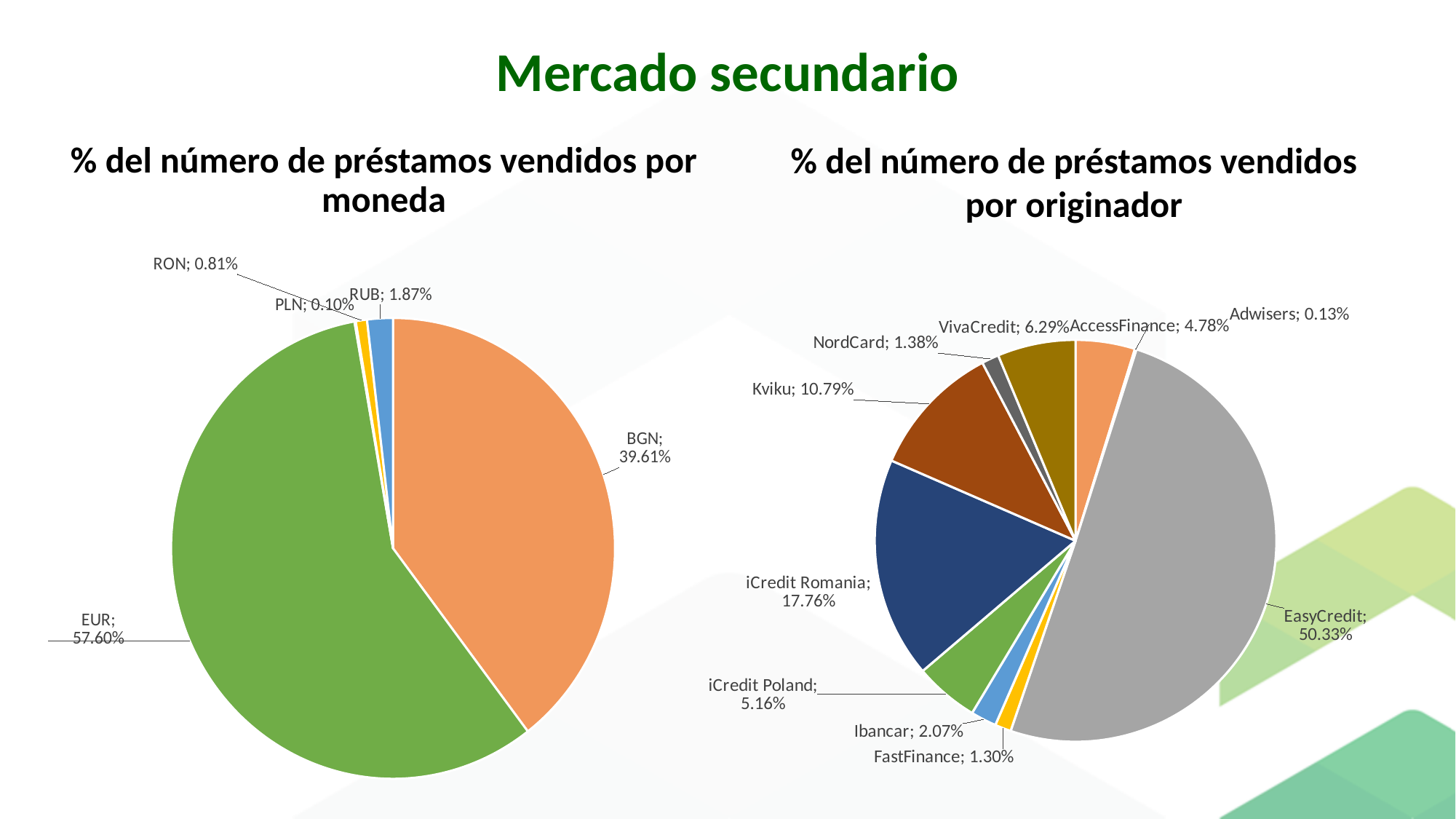
What kind of chart is '% del número de préstamos vendidos por originador'? Pie chart In the chart '% del número de préstamos vendidos por moneda', what is the value for BGN? 39.61% In the chart '% del número de préstamos vendidos por originador', what is the value for iCredit Romania? 17.76% In the chart '% del número de préstamos vendidos por moneda', which currency has the smallest share? PLN In the chart '% del número de préstamos vendidos por originador', how many originators are shown? 10 In the chart '% del número de préstamos vendidos por originador', which originator has the smallest share? Adwisers In the chart '% del número de préstamos vendidos por moneda', what is the value for EUR? 57.60% In the chart '% del número de préstamos vendidos por moneda', how many currency categories are shown? 5 In the chart '% del número de préstamos vendidos por moneda', what is the difference between the EUR and BGN shares? 17.99% In the chart '% del número de préstamos vendidos por originador', what is the value for Kviku? 10.79% In the chart '% del número de préstamos vendidos por originador', which originator has the largest share? EasyCredit In the chart '% del número de préstamos vendidos por originador', which is larger, the share for VivaCredit or the share for AccessFinance? VivaCredit